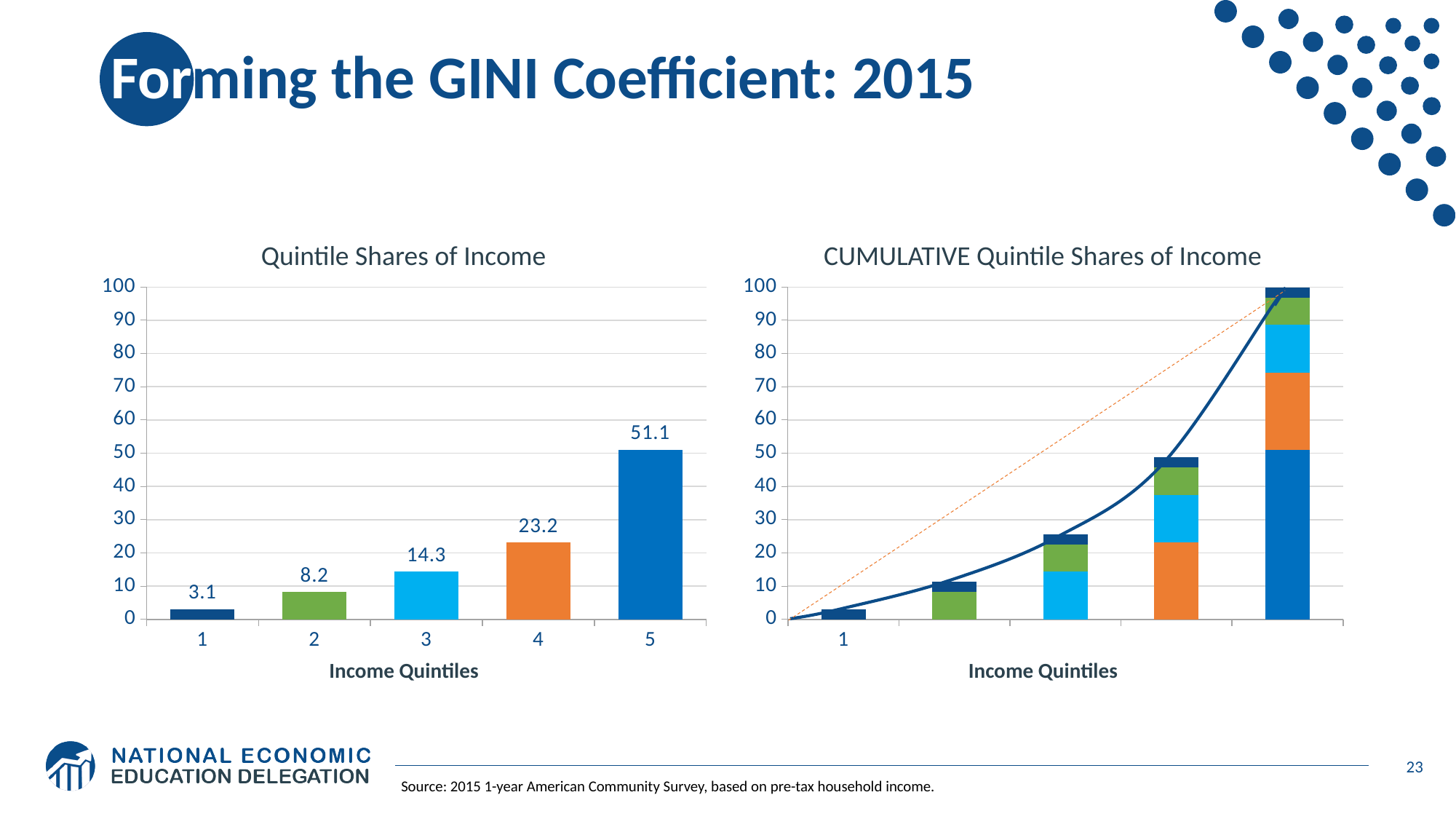
In the 'CUMULATIVE Quintile Shares of Income' chart, is the value for income quintile 1 greater or less than 10? less In the 'Quintile Shares of Income' chart, do the values rise or fall as the quintile number increases? rise In the 'Quintile Shares of Income' chart, which income quintile has the lowest share? 1 What is the title of the chart on the right side of the slide? CUMULATIVE Quintile Shares of Income What kind of chart is the 'Quintile Shares of Income' chart? bar chart In the 'Quintile Shares of Income' chart, how many income quintiles are plotted? 5 In the 'Quintile Shares of Income' chart, what is the difference between the values for quintile 5 and quintile 4? 27.9 In the 'Quintile Shares of Income' chart, what is the value for income quintile 3? 14.3 In the 'Quintile Shares of Income' chart, what is the difference between the values for quintile 2 and quintile 1? 5.1 In the 'Quintile Shares of Income' chart, which is larger, the value for quintile 3 or quintile 4? quintile 4 In the 'Quintile Shares of Income' chart, what is the value for income quintile 5? 51.1 In the 'Quintile Shares of Income' chart, which income quintile has the highest share? 5